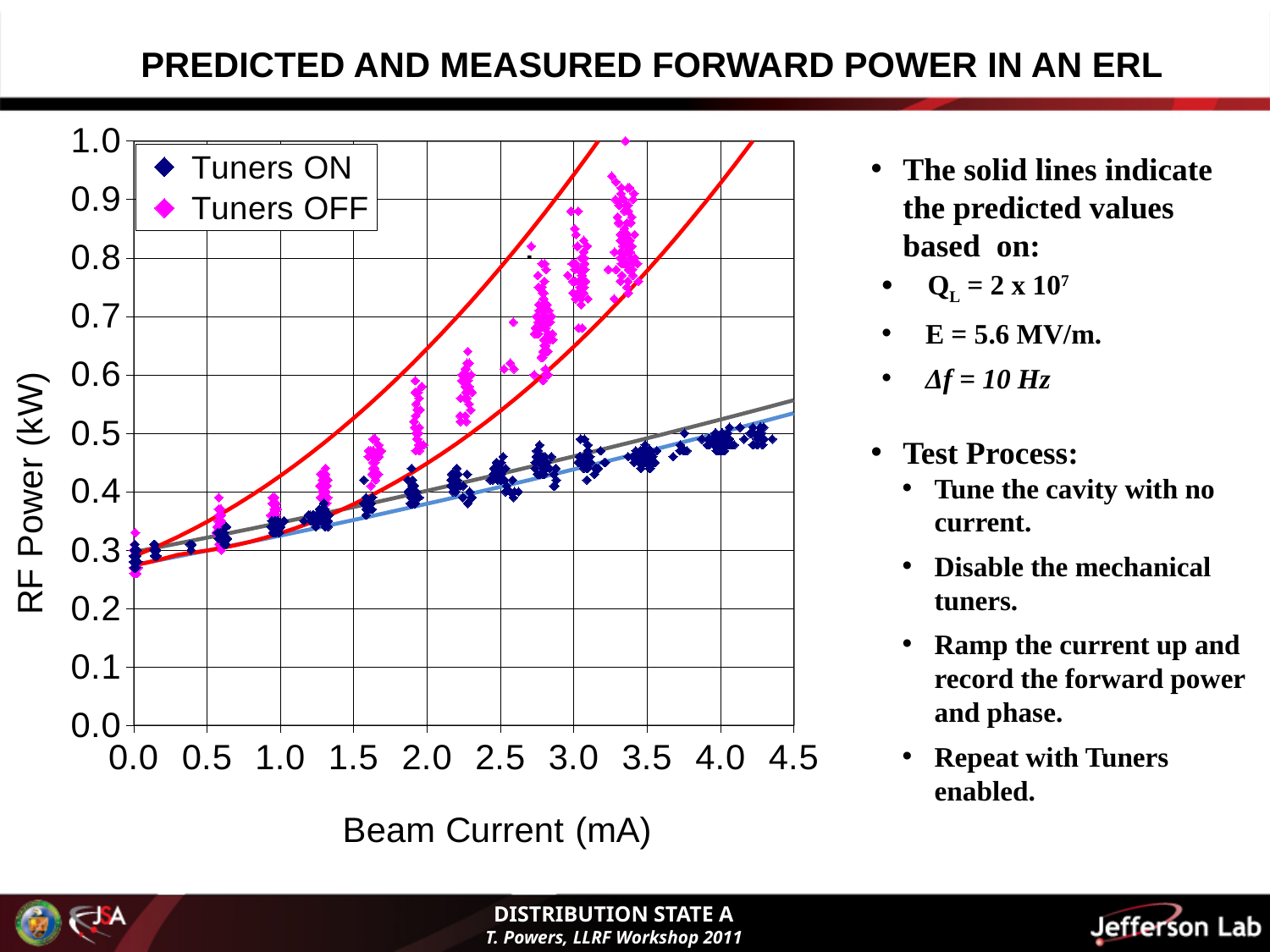
What kind of chart is shown on the slide? scatter chart What are the two series named in the chart legend? Tuners ON and Tuners OFF Does the RF power for the Tuners OFF series rise or fall as beam current increases? rise Which series reaches the highest RF power on the chart? Tuners OFF Is the RF power for the Tuners ON series at 1.0 mA greater or less than 0.4 kW? less Is the RF power for the Tuners ON series at 4.0 mA greater or less than 0.6 kW? less Is the RF power for the Tuners OFF series at 2.0 mA greater or less than 0.4 kW? greater How many series does the chart legend list? 2 At a beam current of about 3.0 mA, which series shows the higher RF power, Tuners ON or Tuners OFF? Tuners OFF What is the label of the chart's x axis? Beam Current (mA) Does the RF power for the Tuners ON series rise or fall as beam current increases? rise